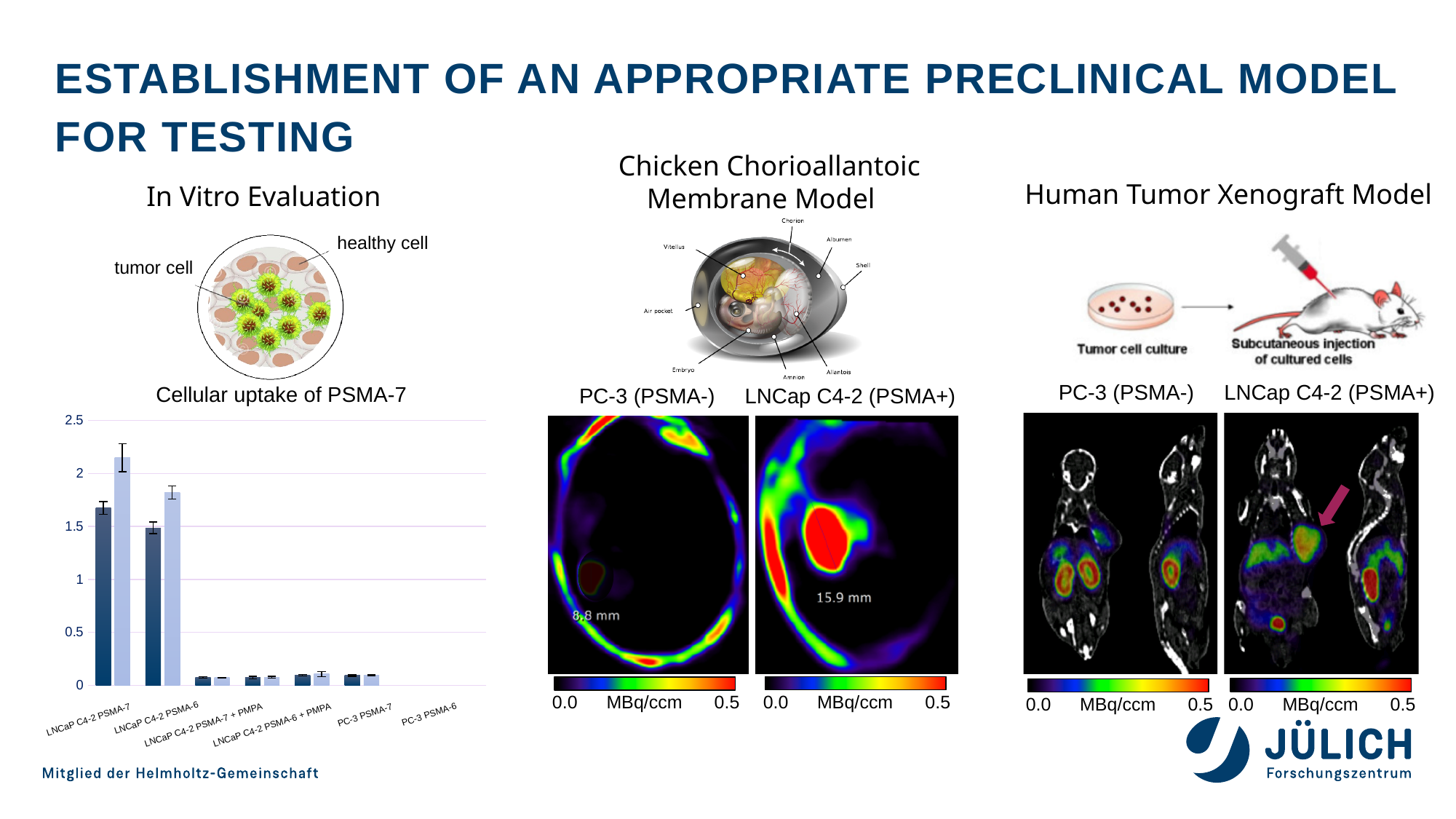
What kind of chart is the 'Cellular uptake of PSMA-7' chart? bar chart In the 'Cellular uptake of PSMA-7' chart, which category has the tallest bar? LNCaP C4-2 PSMA-7 In the 'Cellular uptake of PSMA-7' chart, is the light blue bar for LNCaP C4-2 PSMA-6 greater or less than 2? less In the 'Cellular uptake of PSMA-7' chart, are the bars for LNCaP C4-2 PSMA-7 + PMPA greater or less than 0.5? less In the 'Cellular uptake of PSMA-7' chart, do the bar values generally rise or fall from left to right along the x axis? fall In the 'Cellular uptake of PSMA-7' chart, is the light blue bar for LNCaP C4-2 PSMA-7 greater or less than 2? greater In the 'Cellular uptake of PSMA-7' chart, which is larger: the light blue bar for LNCaP C4-2 PSMA-7 or the light blue bar for LNCaP C4-2 PSMA-6? LNCaP C4-2 PSMA-7 How many categories are shown on the x axis of the 'Cellular uptake of PSMA-7' chart? 6 What is the maximum value shown on the y axis of the 'Cellular uptake of PSMA-7' chart? 2.5 In the 'Cellular uptake of PSMA-7' chart, which is larger: the dark blue bar for LNCaP C4-2 PSMA-6 or the dark blue bar for PC-3 PSMA-7? LNCaP C4-2 PSMA-6